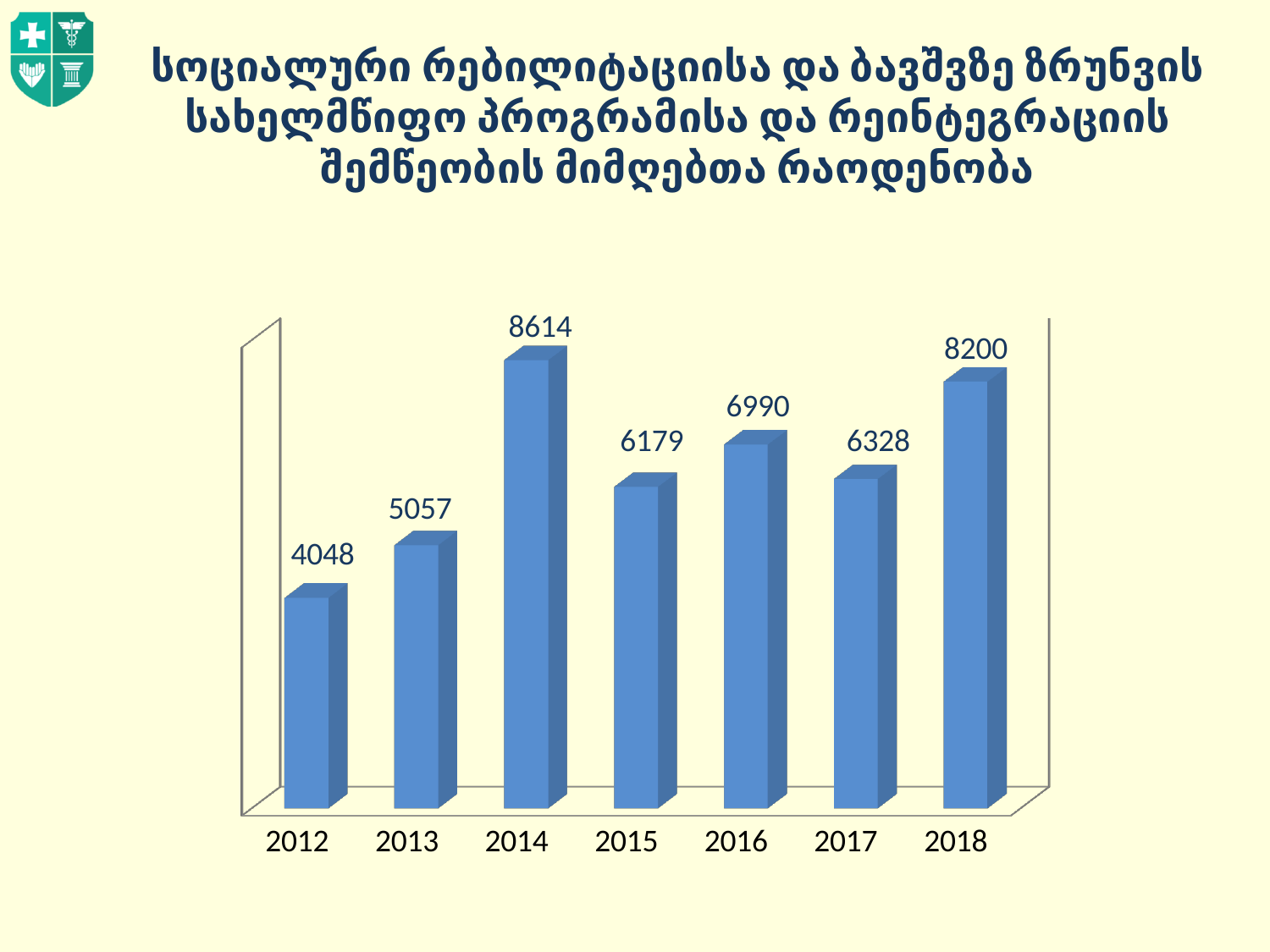
What is the difference between the values for 2014 and 2018? 414 What is the difference between the values for 2013 and 2012? 1009 How many years are shown on the x axis? 7 Do the values rise or fall from 2012 to 2014? rise What is the value for 2018? 8200 Which is larger, the value for 2016 or the value for 2017? 2016 Which year has the lowest value? 2012 Which year has the highest value? 2014 What is the value for 2014? 8614 What is the value for 2012? 4048 What is the value for 2017? 6328 What kind of chart is shown on the slide? bar chart